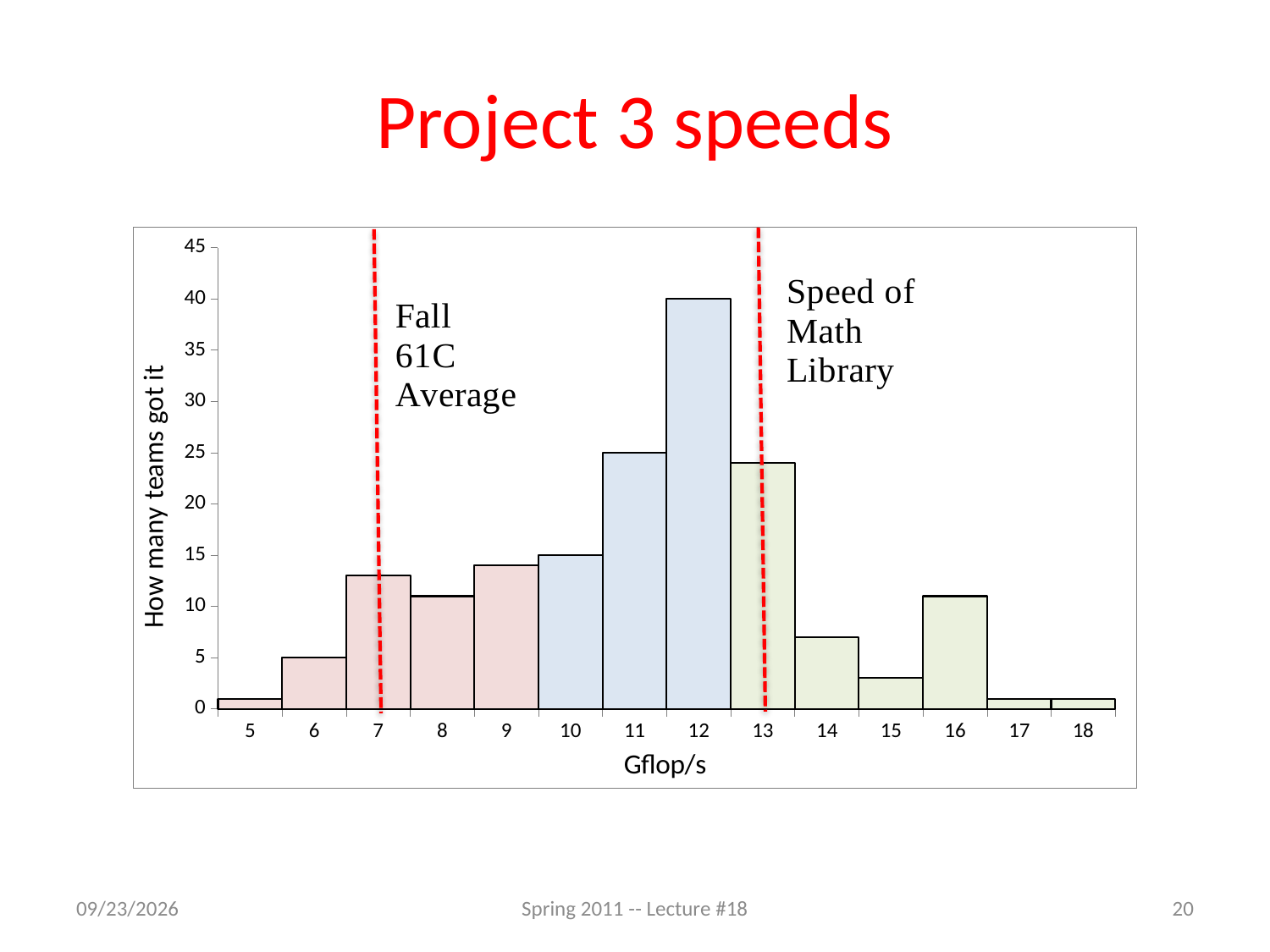
What is the title of the chart on the slide? Project 3 speeds How many teams got 6 Gflop/s? 5 How many teams got 10 Gflop/s? 15 Is the number of teams at 15 Gflop/s greater or less than 5? less What is the label of the x axis? Gflop/s How many teams got 11 Gflop/s? 25 How many teams got 12 Gflop/s? 40 Which has more teams: 14 Gflop/s or 16 Gflop/s? 16 Gflop/s Which Gflop/s value has the highest number of teams? 12 What kind of chart is shown on the slide? bar chart How many bars (Gflop/s categories) are plotted in the chart? 14 Is the number of teams at 7 Gflop/s greater or less than 10? greater